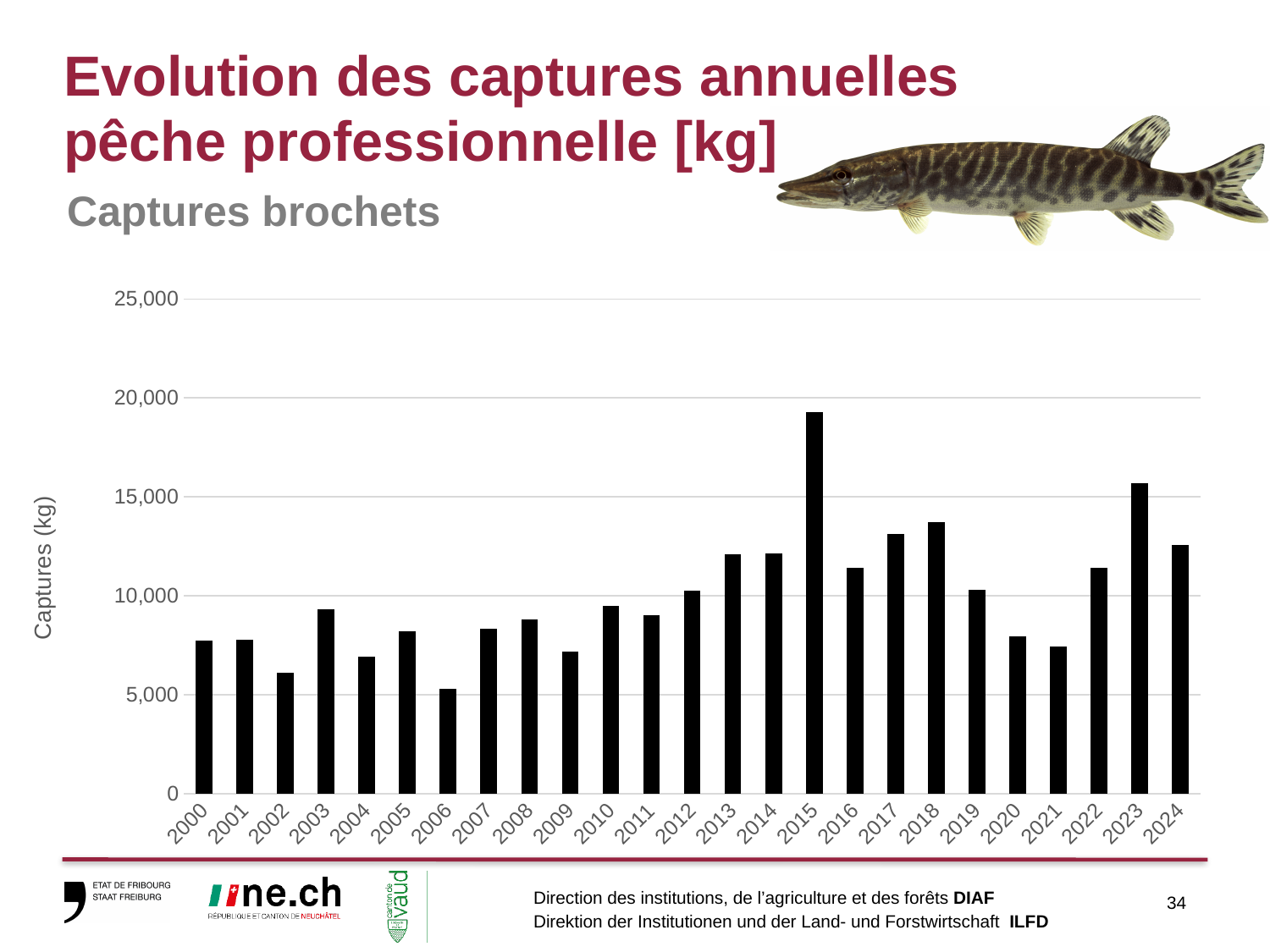
Which year has the larger catch, 2003 or 2006? 2003 Is the value for 2023 greater or less than 15,000? greater Which year has the lowest catch in the chart? 2006 What kind of chart is shown on the slide? bar chart Which year has the larger catch, 2015 or 2023? 2015 How many years are plotted on the x axis of the chart? 25 Is the value for 2018 greater or less than 10,000? greater Do the values rise or fall from 2019 to 2021? fall Is the value for 2015 greater or less than 15,000? greater What is the label on the y axis of the chart? Captures (kg) Which year has the highest catch in the chart? 2015